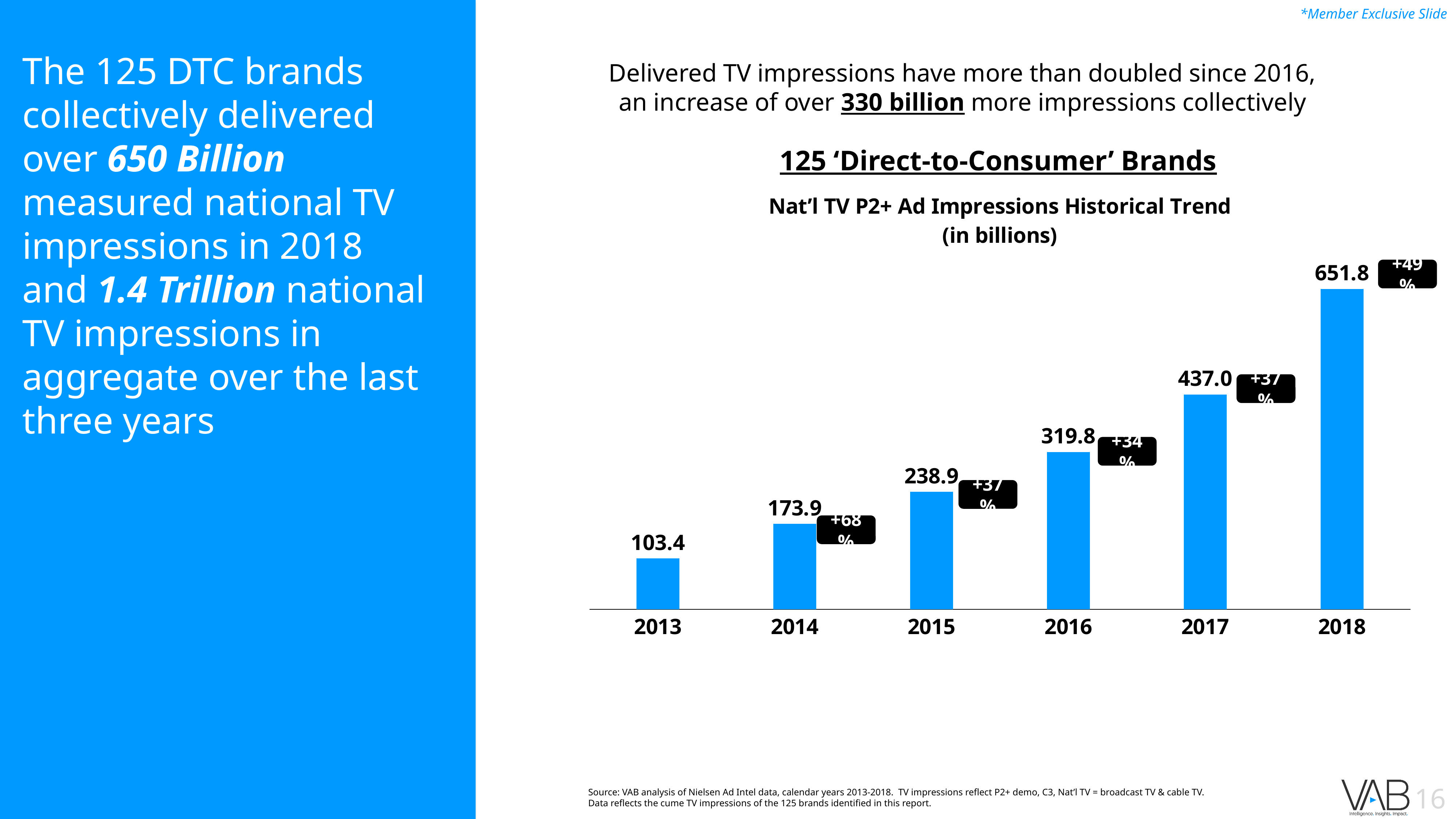
What unit does the chart subtitle say the values are in? billions How many years are shown on the x axis? 6 Which is larger, the value for 2016 or the value for 2015? 2016 What is the difference between the 2018 and 2017 values? 214.8 What is the value for 2018? 651.8 What is the value for 2013? 103.4 What is the value for 2016? 319.8 What kind of chart is this? bar chart Which year has the highest value? 2018 Which year has the lowest value? 2013 What is the difference between the 2015 and 2014 values? 65.0 Do the values rise or fall from 2013 to 2018? rise